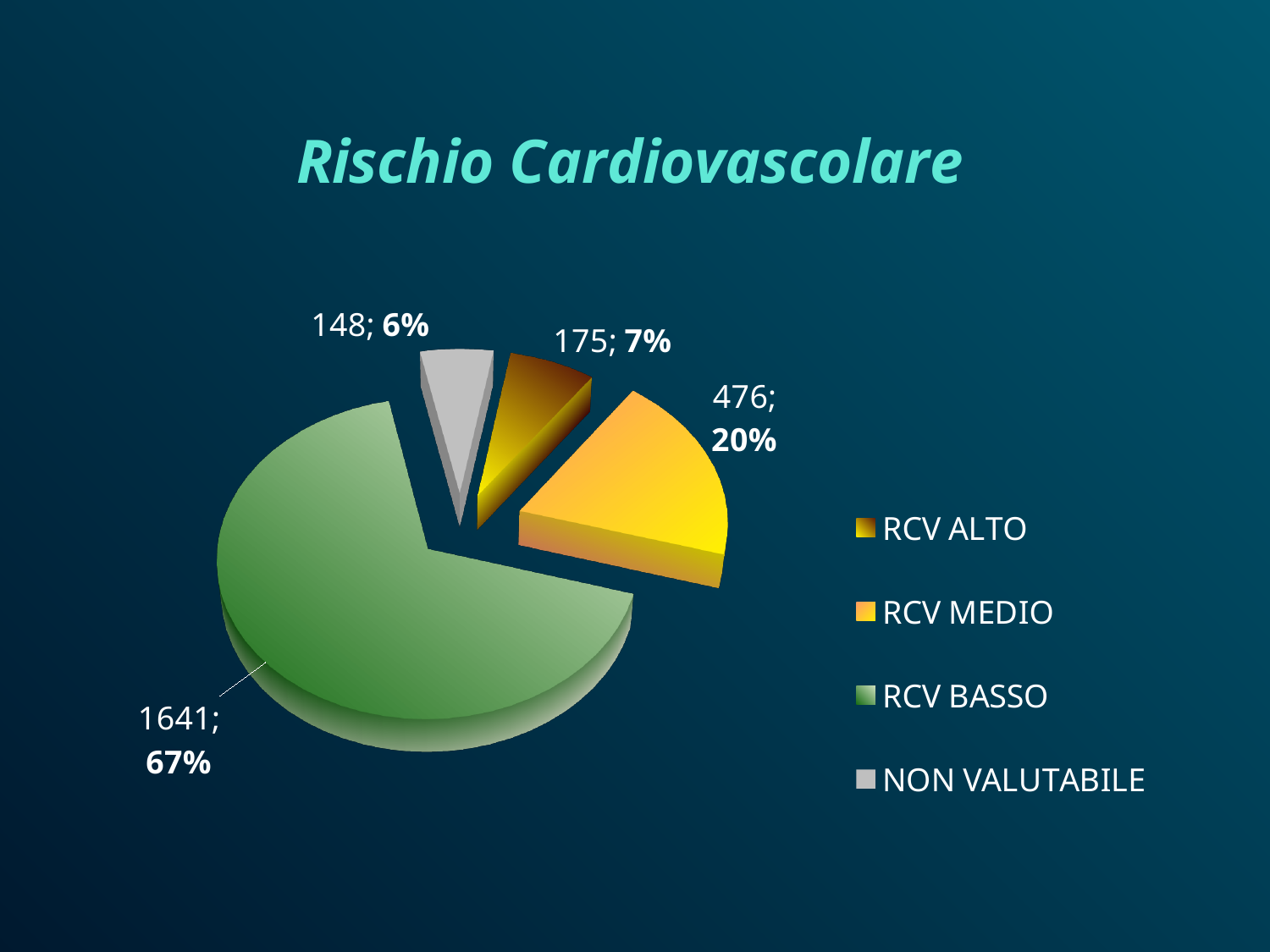
How many categories does the pie chart show? 4 What is the count shown for RCV ALTO? 175 What colour is the RCV BASSO slice? Green What kind of chart is shown on the slide? Pie chart Which category has the largest slice of the pie? RCV BASSO What is the title of the chart? Rischio Cardiovascolare What is the count shown for RCV BASSO? 1641 What percentage of the pie does NON VALUTABILE represent? 6% Which is larger, the count for RCV ALTO or the count for NON VALUTABILE? RCV ALTO What is the difference between the counts for RCV MEDIO and RCV ALTO? 301 What percentage of the pie does RCV MEDIO represent? 20% Which category has the smallest slice of the pie? NON VALUTABILE